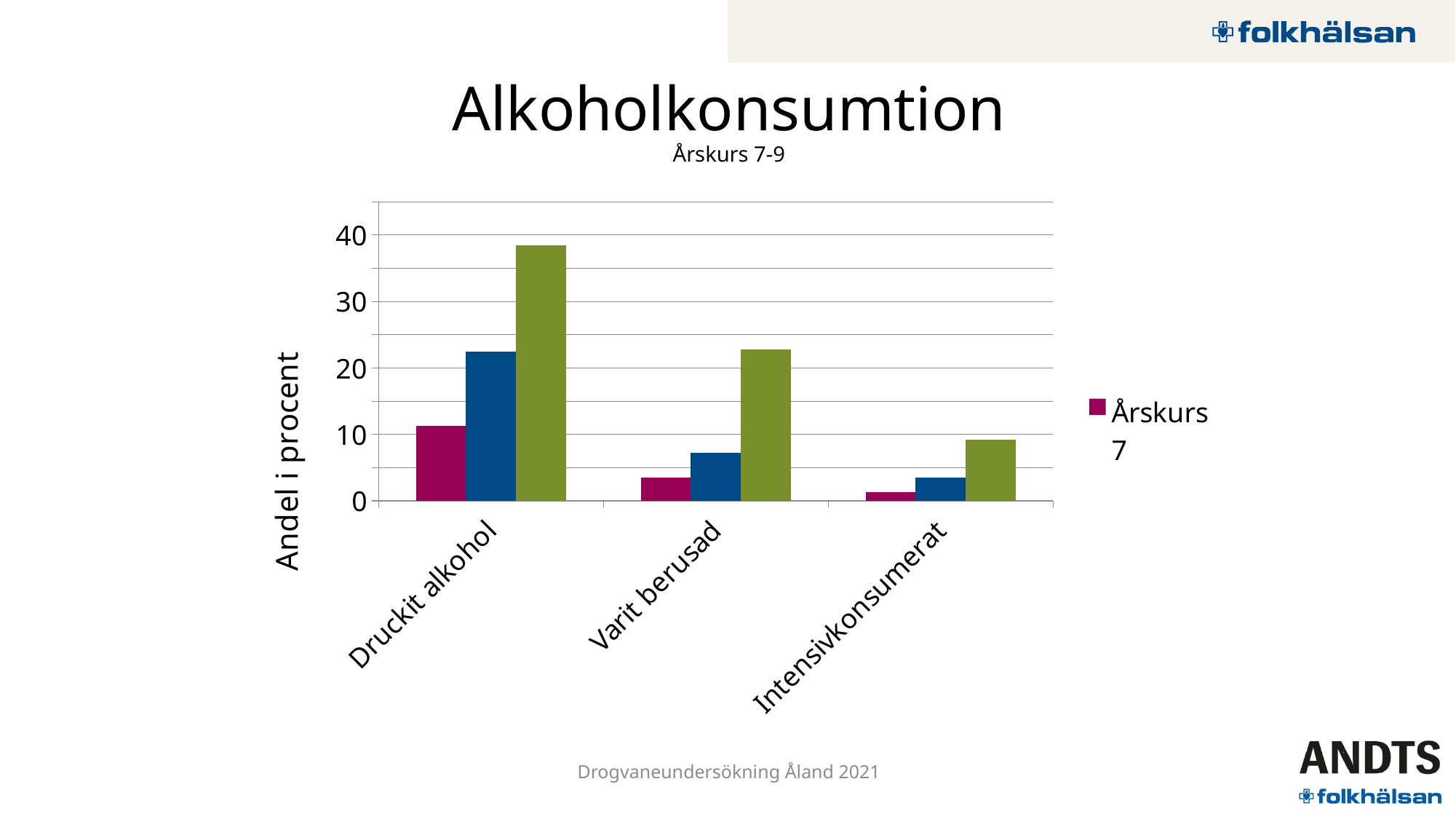
Is the value of the Årskurs 7 bar for Druckit alkohol greater or less than 20? less Is the value of the Årskurs 7 bar for Intensivkonsumerat greater or less than 10? less How many categories are shown on the x axis of the chart? 3 What is the title of the chart on the slide? Alkoholkonsumtion Is the value of the green bar for Varit berusad greater or less than 20? greater Which category has the highest value for Årskurs 7? Druckit alkohol Which category has the lowest value for Årskurs 7? Intensivkonsumerat What is the label of the vertical axis? Andel i procent Which is larger: the green bar for Druckit alkohol or the green bar for Varit berusad? Druckit alkohol What kind of chart is shown on the slide? bar chart